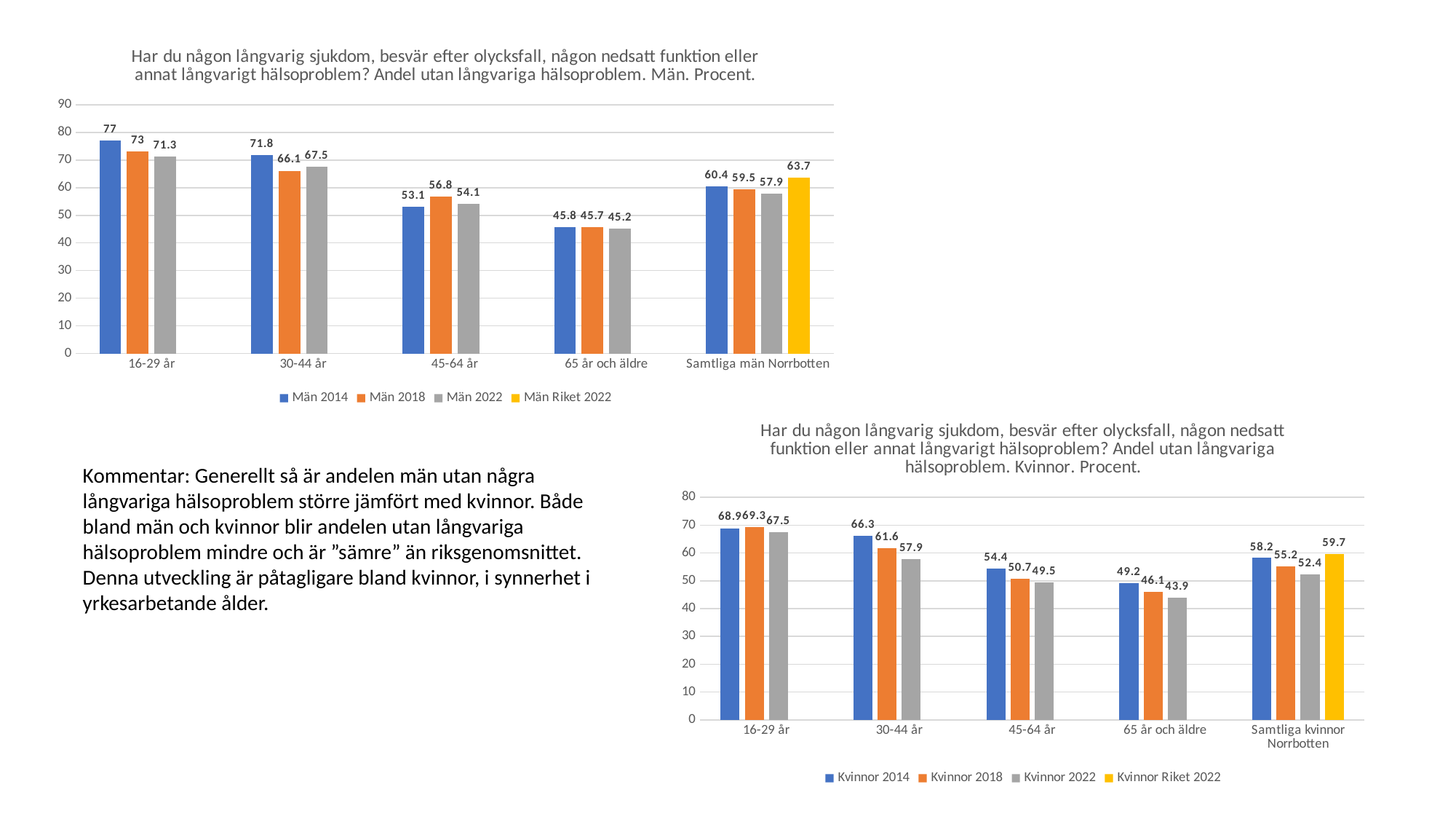
In the women's chart (bottom right), what is the value for Kvinnor 2018 in the 65 år och äldre group? 46.1 How many categories are shown on the x axis of the men's chart (top left)? 5 In the men's chart (top left), what is the value for Män 2014 in the 16-29 år group? 77 What kind of chart is the women's chart (bottom right)? Bar chart In the men's chart (top left), which age group has the lowest value for Män 2022? 65 år och äldre In the women's chart (bottom right), what is the value for Kvinnor 2022 in the 30-44 år group? 57.9 In the men's chart (top left), what is the value for Män Riket 2022 for Samtliga män Norrbotten? 63.7 How many series does the legend of the women's chart (bottom right) list? 4 In the men's chart (top left), which is larger in the 45-64 år group: Män 2014 or Män 2018? Män 2018 In the men's chart (top left), what is the difference between Män 2014 and Män 2022 in the 30-44 år group? 4.3 In the women's chart (bottom right), which category has the highest value for Kvinnor 2014? 16-29 år In the women's chart (bottom right), what is the difference between Kvinnor Riket 2022 and Kvinnor 2022 for Samtliga kvinnor Norrbotten? 7.3